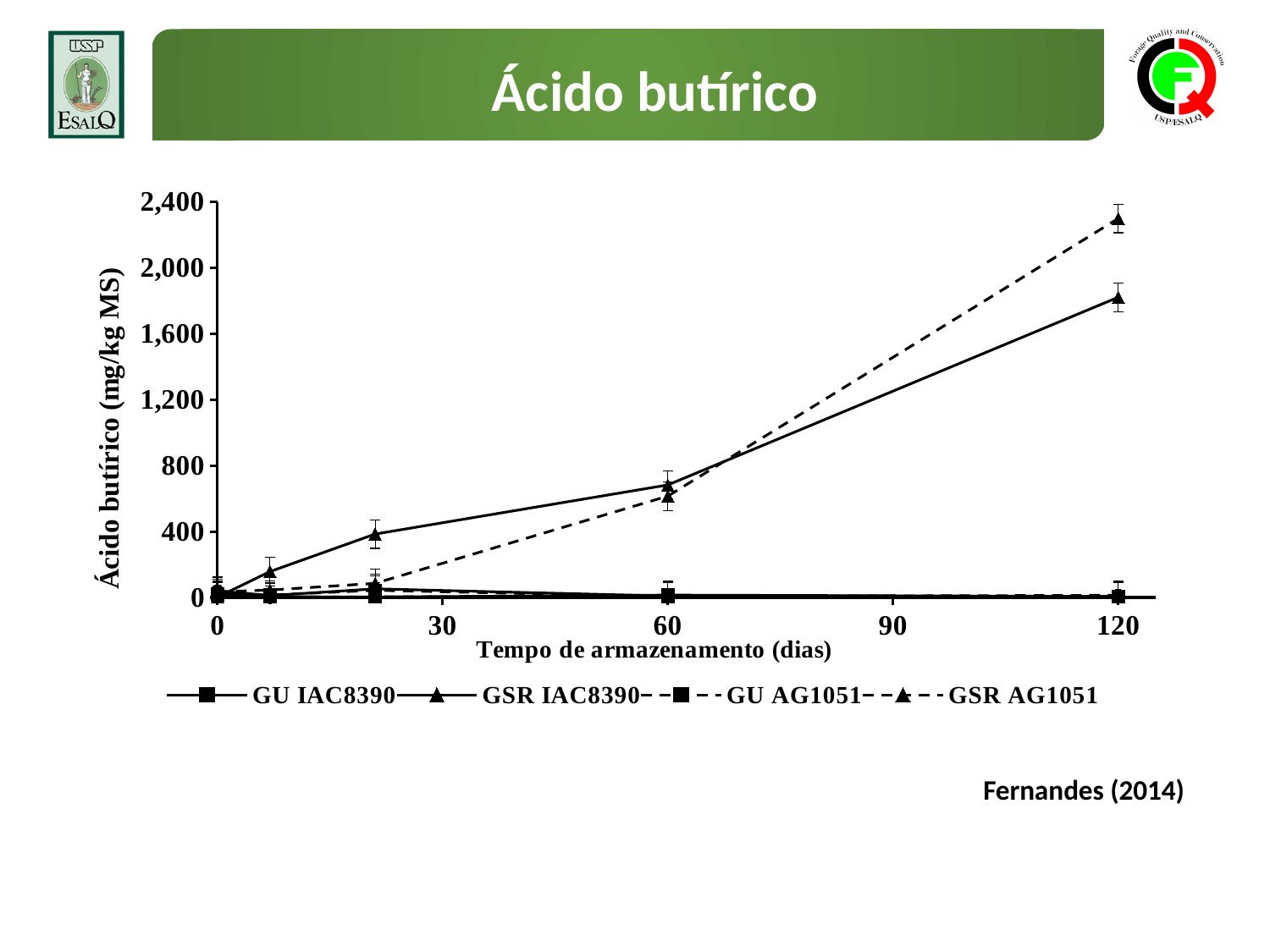
Is the value for GSR IAC8390 at 120 days greater or less than 2,000? less Does the GSR AG1051 series rise or fall from 0 to 120 days? rise Is the value for GU IAC8390 at 120 days greater or less than 400? less Is the value for GSR IAC8390 at 120 days greater or less than 1,600? greater What kind of chart is shown on the slide? line chart How many tick labels are shown on the x axis? 5 How many series does the legend list? 4 What is the title of the y axis? Ácido butírico (mg/kg MS) Which series has the highest value at 120 days? GSR AG1051 What is the title of the x axis? Tempo de armazenamento (dias)